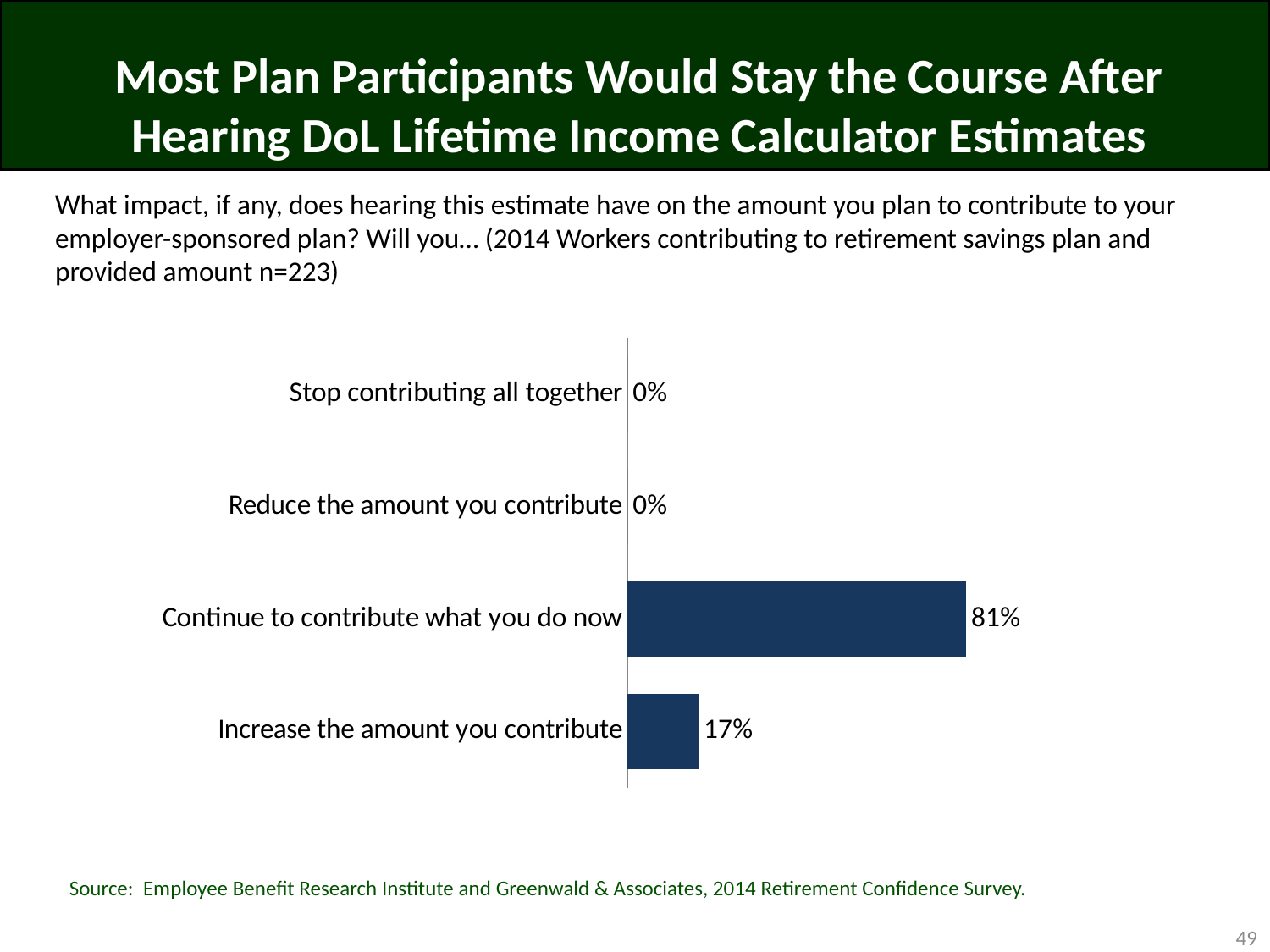
What percentage of respondents said they would stop contributing all together? 0% What percentage of respondents said they would increase the amount they contribute? 17% What type of chart is shown on the slide? Bar chart What percentage of respondents said they would reduce the amount they contribute? 0% What percentage of respondents said they would continue to contribute what they do now? 81% How many categories in the chart have a value of 0%? 2 Which response category has the highest value? Continue to contribute what you do now Which is larger: the value for 'Increase the amount you contribute' or the value for 'Reduce the amount you contribute'? Increase the amount you contribute How many response categories are shown in the chart? 4 What is the source cited for the chart? Employee Benefit Research Institute and Greenwald & Associates, 2014 Retirement Confidence Survey What is the difference between the percentage who would continue to contribute what they do now and the percentage who would increase the amount they contribute? 64 percentage points What is the sample size (n) given for the survey question shown on the slide? 223